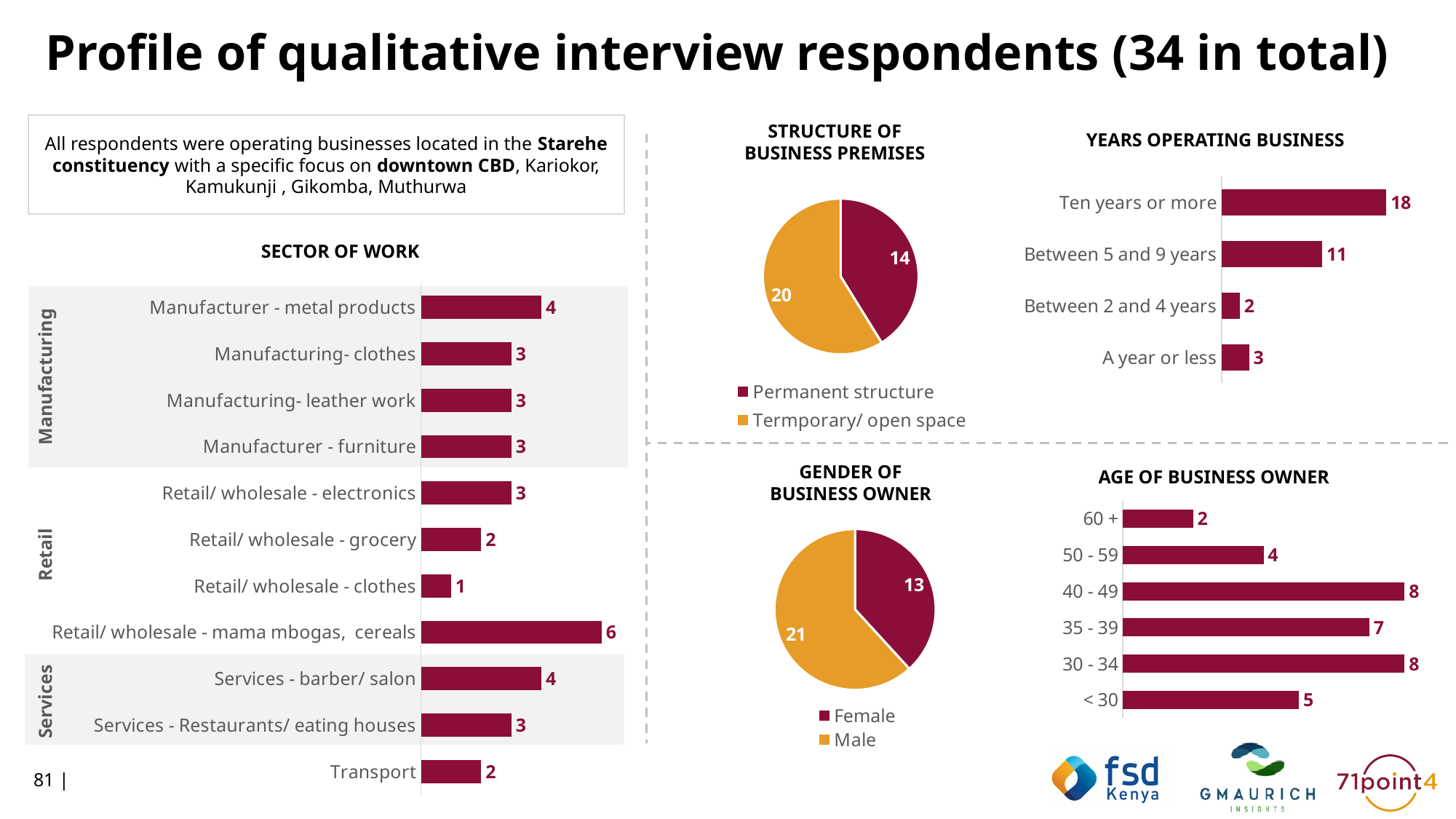
What type of chart is 'Gender of Business Owner'? Pie chart In the 'Age of Business Owner' chart, what is the value for '35 - 39'? 7 What type of chart is 'Years Operating Business'? Bar chart In the 'Structure of Business Premises' pie chart, which slice is larger: 'Permanent structure' or 'Termporary/ open space'? Termporary/ open space In the 'Sector of Work' chart, which category has the lowest value? Retail/ wholesale - clothes In the 'Sector of Work' chart, what is the value for 'Retail/ wholesale - mama mbogas, cereals'? 6 In the 'Gender of Business Owner' pie chart, what is the value for 'Male'? 21 In the 'Years Operating Business' chart, what is the difference between 'Ten years or more' and 'Between 5 and 9 years'? 7 In the 'Years Operating Business' chart, what is the value for 'Ten years or more'? 18 How many categories are plotted in the 'Sector of Work' chart? 11 In the 'Age of Business Owner' chart, which age group has the lowest value? 60 + In the 'Structure of Business Premises' pie chart, what is the value for 'Permanent structure'? 14